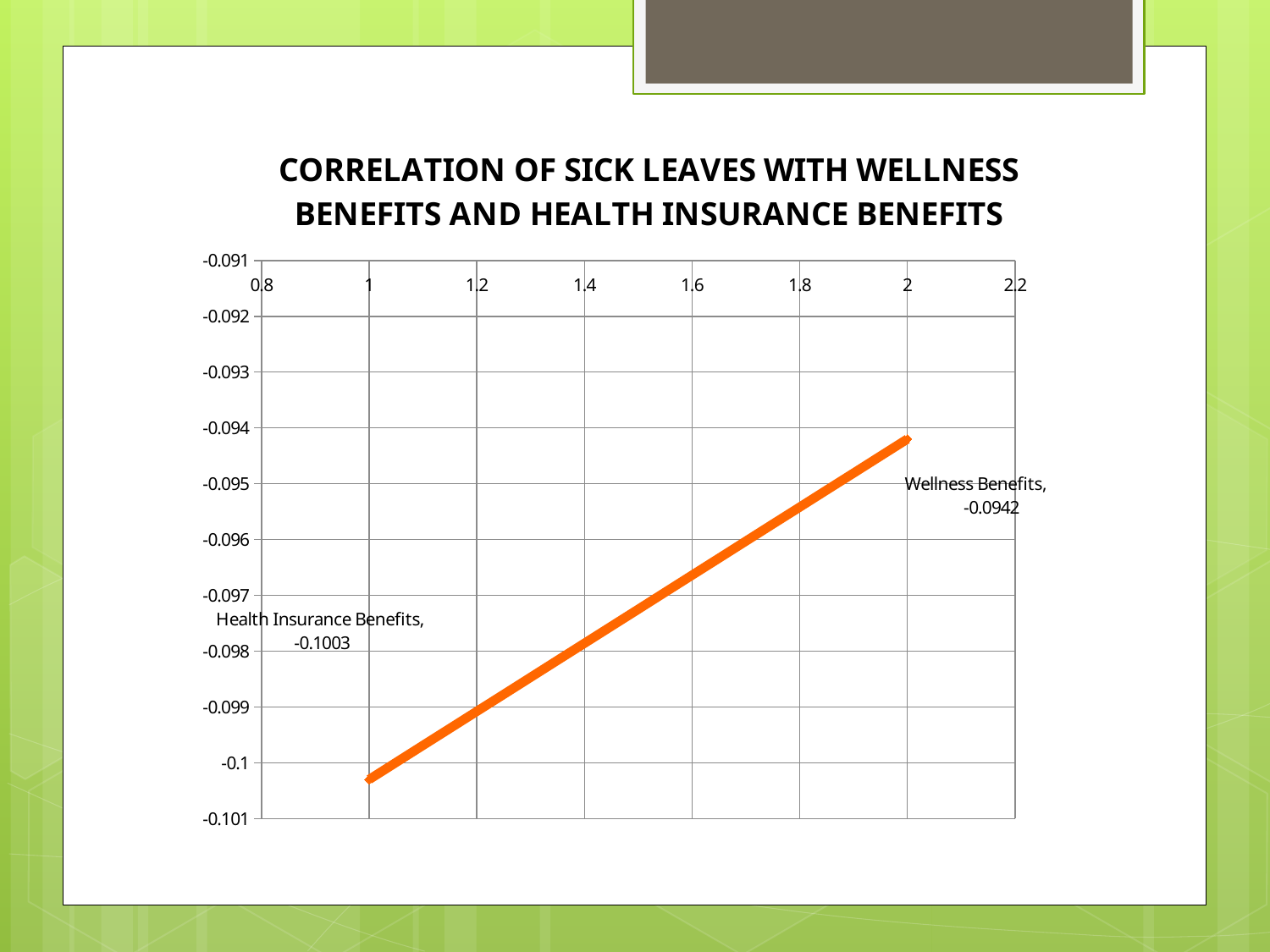
Does the line rise or fall from left to right along the x axis? rises Which of the two labelled points has the lower value? Health Insurance Benefits Is the value for Wellness Benefits greater or less than -0.095? greater What is the difference between the Wellness Benefits value and the Health Insurance Benefits value? 0.0061 What kind of chart is shown on the slide? line chart What is the title of the chart? CORRELATION OF SICK LEAVES WITH WELLNESS BENEFITS AND HEALTH INSURANCE BENEFITS Is the value for Wellness Benefits larger or smaller than the value for Health Insurance Benefits? larger Which of the two labelled points has the higher value? Wellness Benefits What is the value shown for Health Insurance Benefits? -0.1003 How many labelled data points are plotted on the chart? 2 What is the value shown for Wellness Benefits? -0.0942 Is the value for Health Insurance Benefits greater or less than -0.1? less